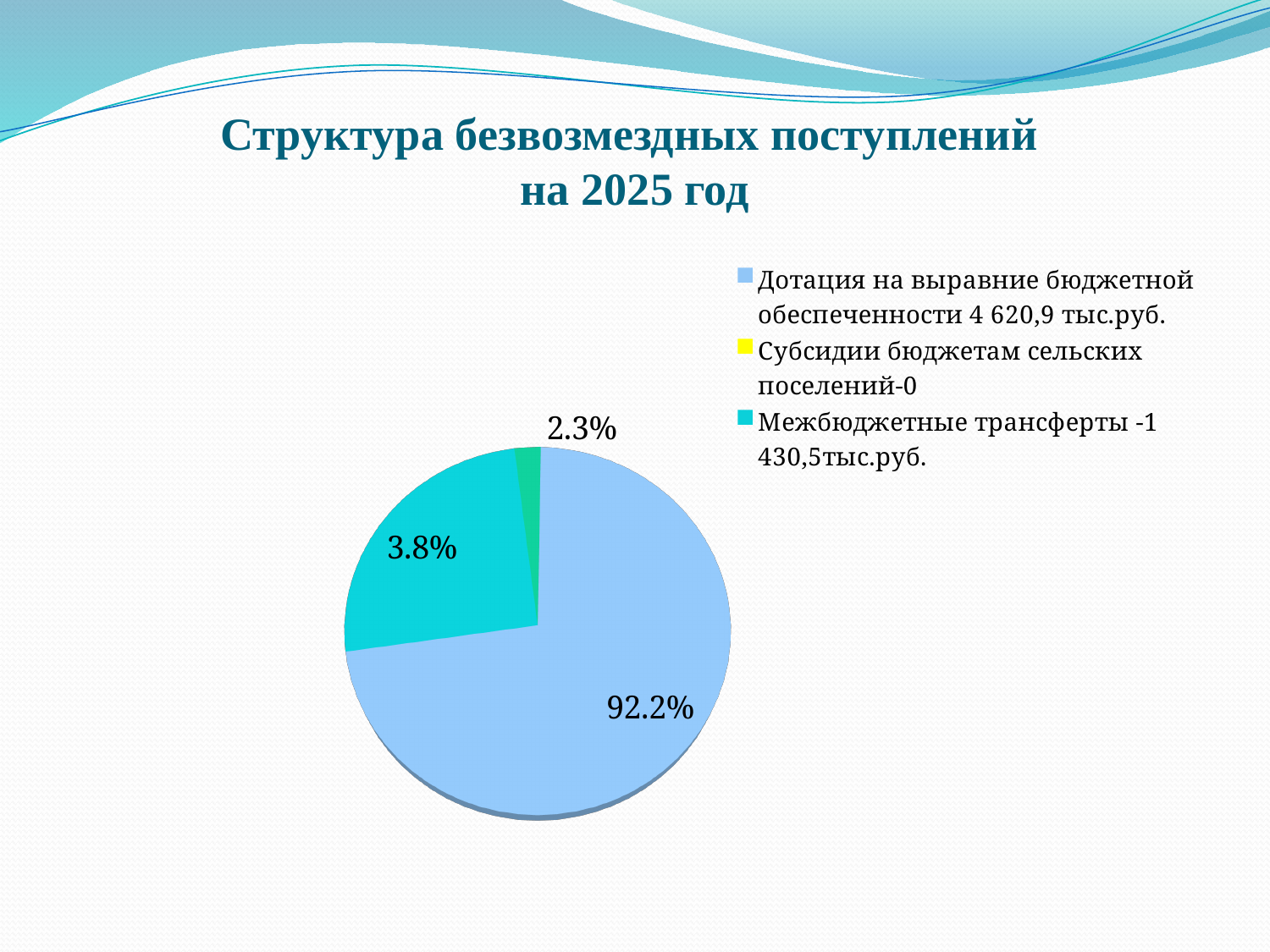
What is the smallest percentage printed on the pie chart? 2.3% Which category has the largest slice of the pie? Дотация на выравние бюджетной обеспеченности How many percentage labels are printed on the pie chart? 3 What is the difference in percentage points between the 92.2% slice and the 3.8% slice? 88.4 What amount does the legend give for Дотация на выравние бюджетной обеспеченности? 4 620,9 тыс.руб. What share of the pie is labelled for Дотация на выравние бюджетной обеспеченности? 92.2% Which is larger, the 3.8% slice or the 2.3% slice? 3.8% What is the title of the slide? Структура безвозмездных поступлений на 2025 год Is the share for Дотация на выравние бюджетной обеспеченности greater or less than 50%? greater What kind of chart is shown on the slide? pie chart What share of the pie is labelled for Межбюджетные трансферты? 3.8% How many entries does the legend list? 3